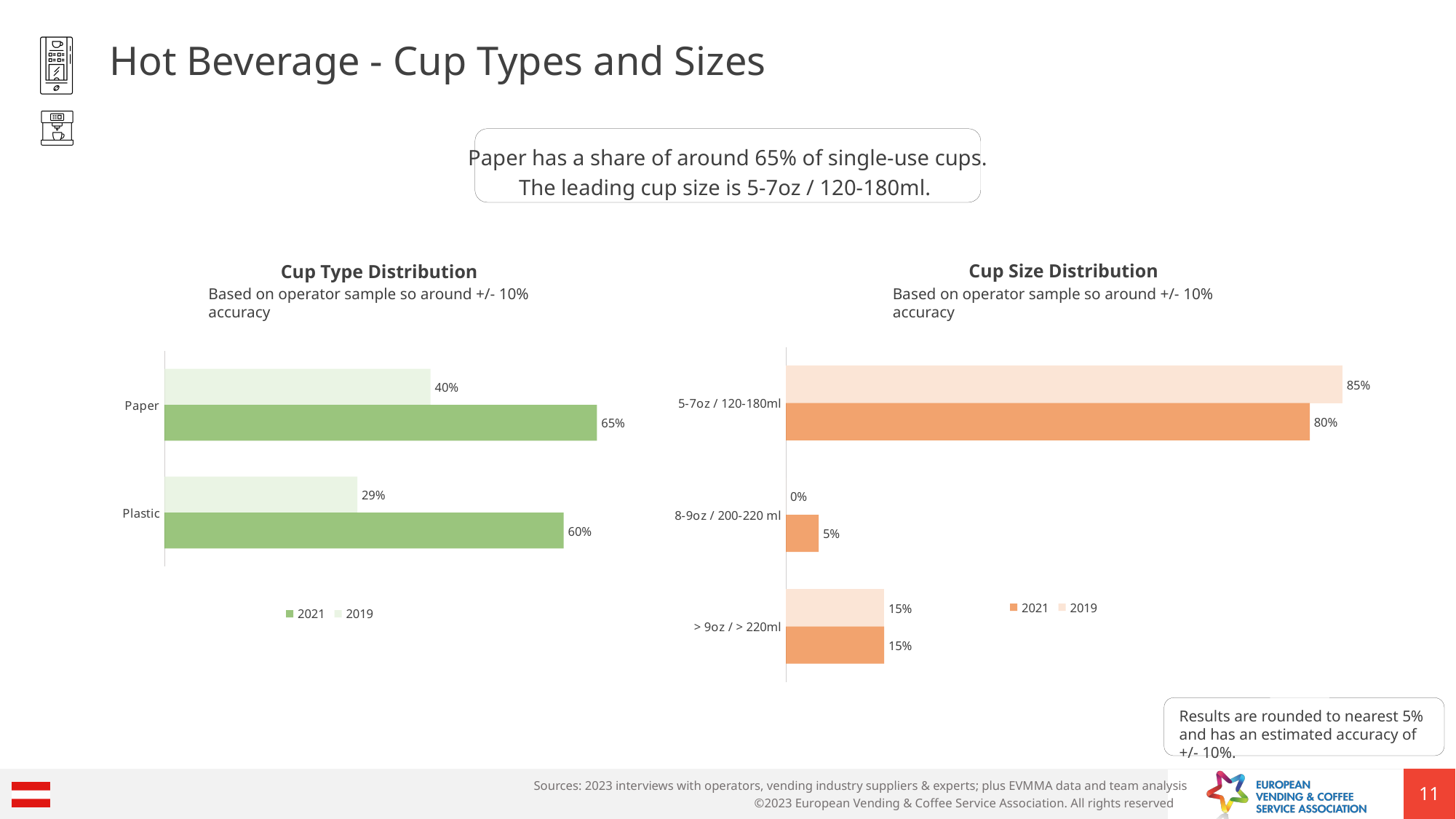
In the Cup Type Distribution chart, what is the value for Paper in 2021? 65% In the Cup Type Distribution chart, what is the difference between the 2021 and 2019 values for Paper? 25% In the Cup Size Distribution chart, which cup size has the highest 2021 value? 5-7oz / 120-180ml In the Cup Type Distribution chart, what is the value for Plastic in 2019? 29% In the Cup Type Distribution chart, how many series does the legend list? 2 In the Cup Size Distribution chart, which cup size has the lowest 2019 value? 8-9oz / 200-220 ml In the Cup Size Distribution chart, how many cup size categories are shown? 3 In the Cup Size Distribution chart, what is the value for 8-9oz / 200-220 ml in 2021? 5% In the Cup Size Distribution chart, what is the difference between the 2019 and 2021 values for 5-7oz / 120-180ml? 5% In the Cup Type Distribution chart, which category has the higher 2021 value, Paper or Plastic? Paper In the Cup Size Distribution chart, what is the value for 5-7oz / 120-180ml in 2019? 85% What kind of chart is the Cup Size Distribution chart? Bar chart